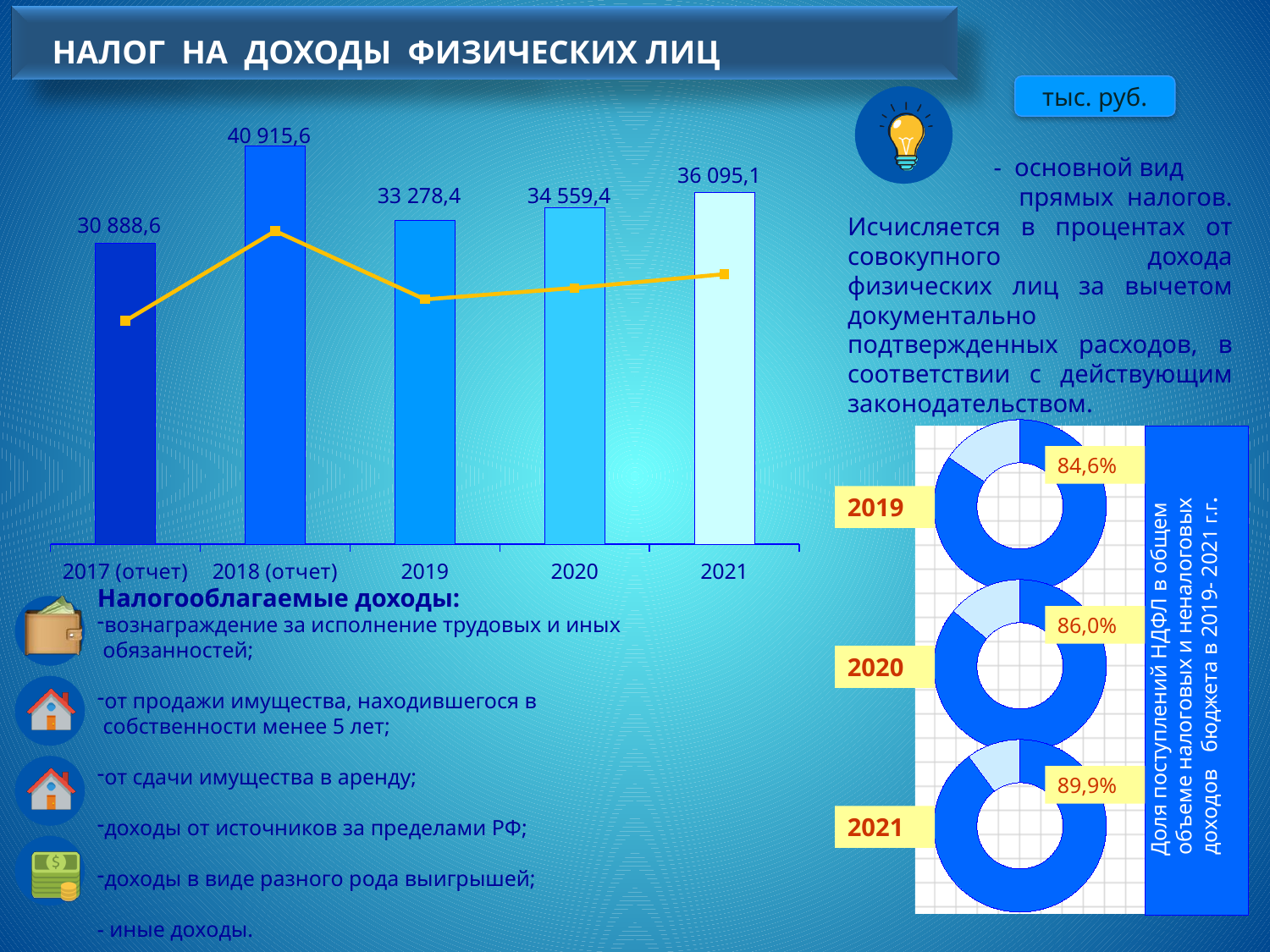
In the donut charts on the right, what share is shown for 2019? 84,6% In the bar chart on the left, what is the value for 2018 (отчет)? 40 915,6 In the bar chart on the left, which is larger: the value for 2019 or the value for 2020? 2020 In the donut charts on the right, do the shares rise or fall from 2019 to 2021? rise In the bar chart on the left, what is the value for 2021? 36 095,1 In the bar chart on the left, which year has the highest value? 2018 (отчет) In the bar chart on the left, what is the value for 2017 (отчет)? 30 888,6 In the bar chart on the left, what is the difference between the values for 2021 and 2020? 1 535,7 In the bar chart on the left, which year has the lowest value? 2017 (отчет) How many years (categories) are shown in the bar chart on the left? 5 In the donut charts on the right, what share is shown for 2021? 89,9% In the bar chart on the left, what is the difference between the values for 2018 (отчет) and 2017 (отчет)? 10 027,0